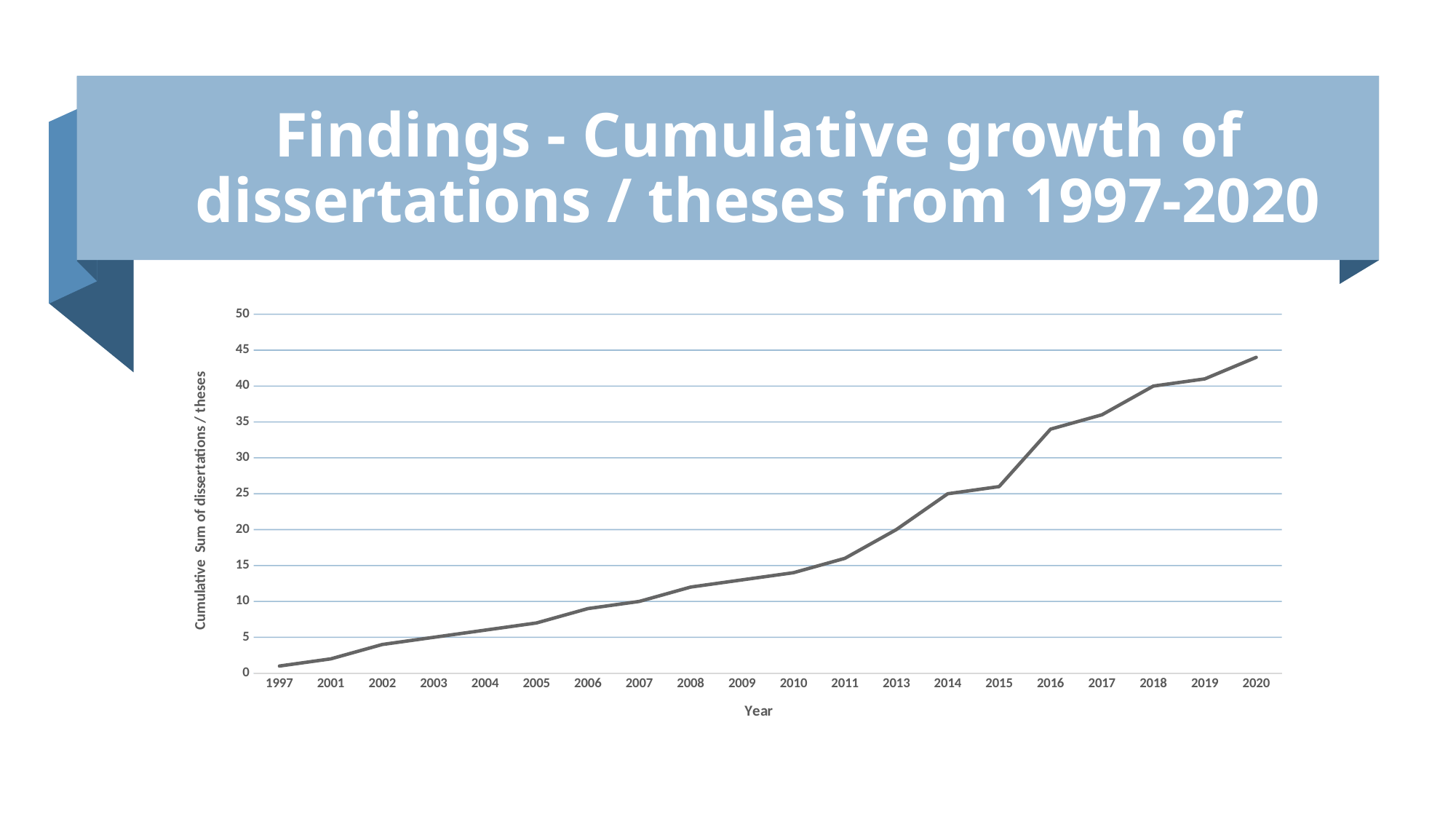
Which year has the lowest cumulative sum of dissertations / theses? 1997 Which year has the larger value, 2011 or 2016? 2016 Is the value for 2016 greater or less than 30? greater What is the label of the y axis? Cumulative Sum of dissertations / theses Do the values rise or fall from 1997 to 2020? rise What kind of chart is shown on the slide? line chart Is the value for 2009 greater or less than 15? less How many years are labelled on the x axis? 20 Which year has the highest cumulative sum of dissertations / theses? 2020 Is the value for 2020 greater or less than 40? greater